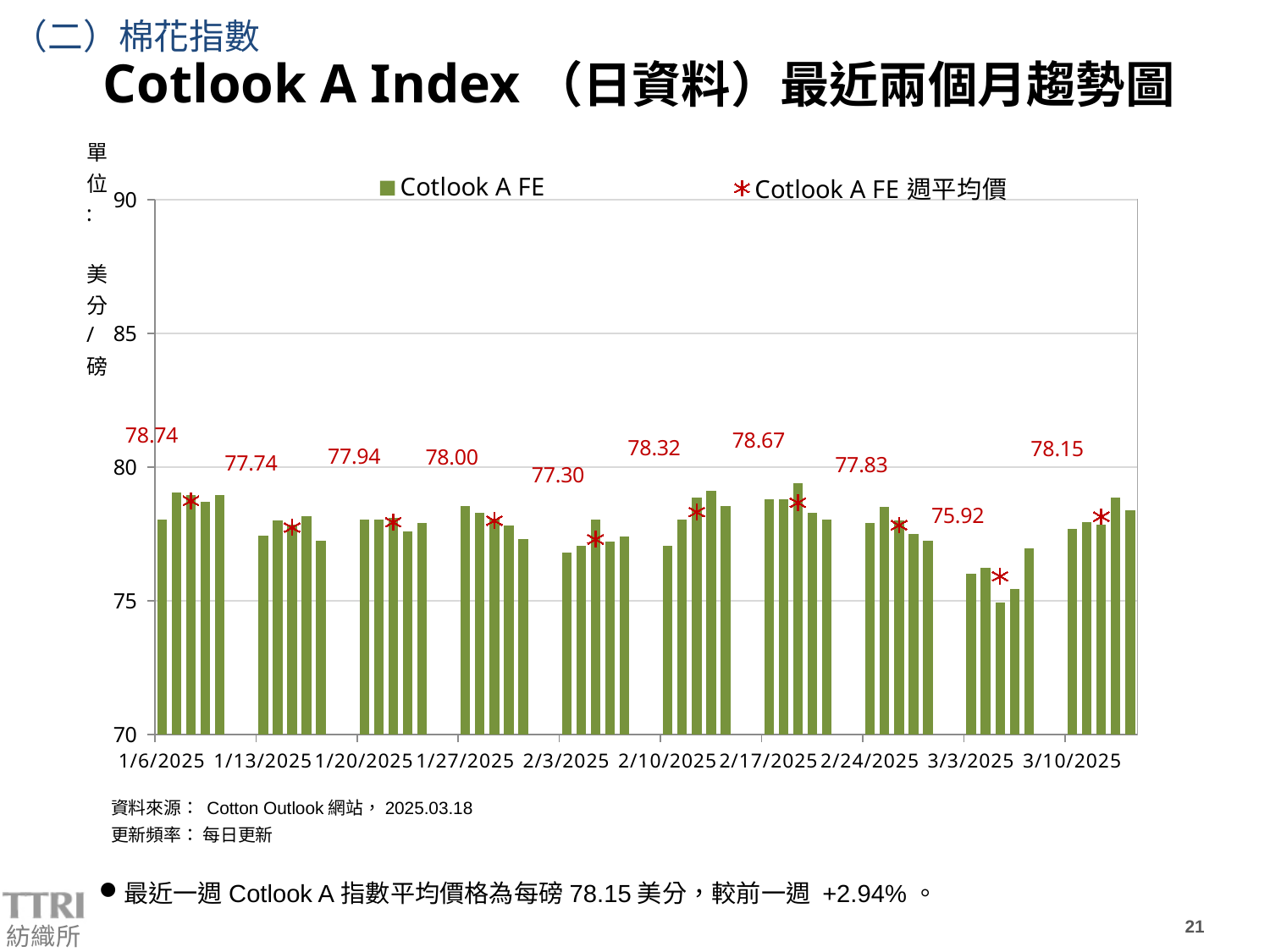
How many weekly average price markers are plotted on the chart? 10 What is the Cotlook A FE weekly average price (週平均價) for the week of 1/6/2025? 78.74 What is the Cotlook A FE weekly average price for the week of 3/10/2025? 78.15 Are the daily Cotlook A FE values in the week of 1/6/2025 greater or less than 75? greater What kind of chart is used to show the daily Cotlook A FE values? Bar chart Which week has the highest Cotlook A FE weekly average price? 1/6/2025 Which week has the lowest Cotlook A FE weekly average price? 3/3/2025 Which is larger, the weekly average price for the week of 2/10/2025 or the week of 2/17/2025? 2/17/2025 What is the difference between the weekly average prices for the weeks of 3/10/2025 and 3/3/2025? 2.23 What is the difference between the weekly average prices for the weeks of 1/6/2025 and 1/13/2025? 1.00 What is the Cotlook A FE weekly average price for the week of 3/3/2025? 75.92 How many series does the legend list? 2